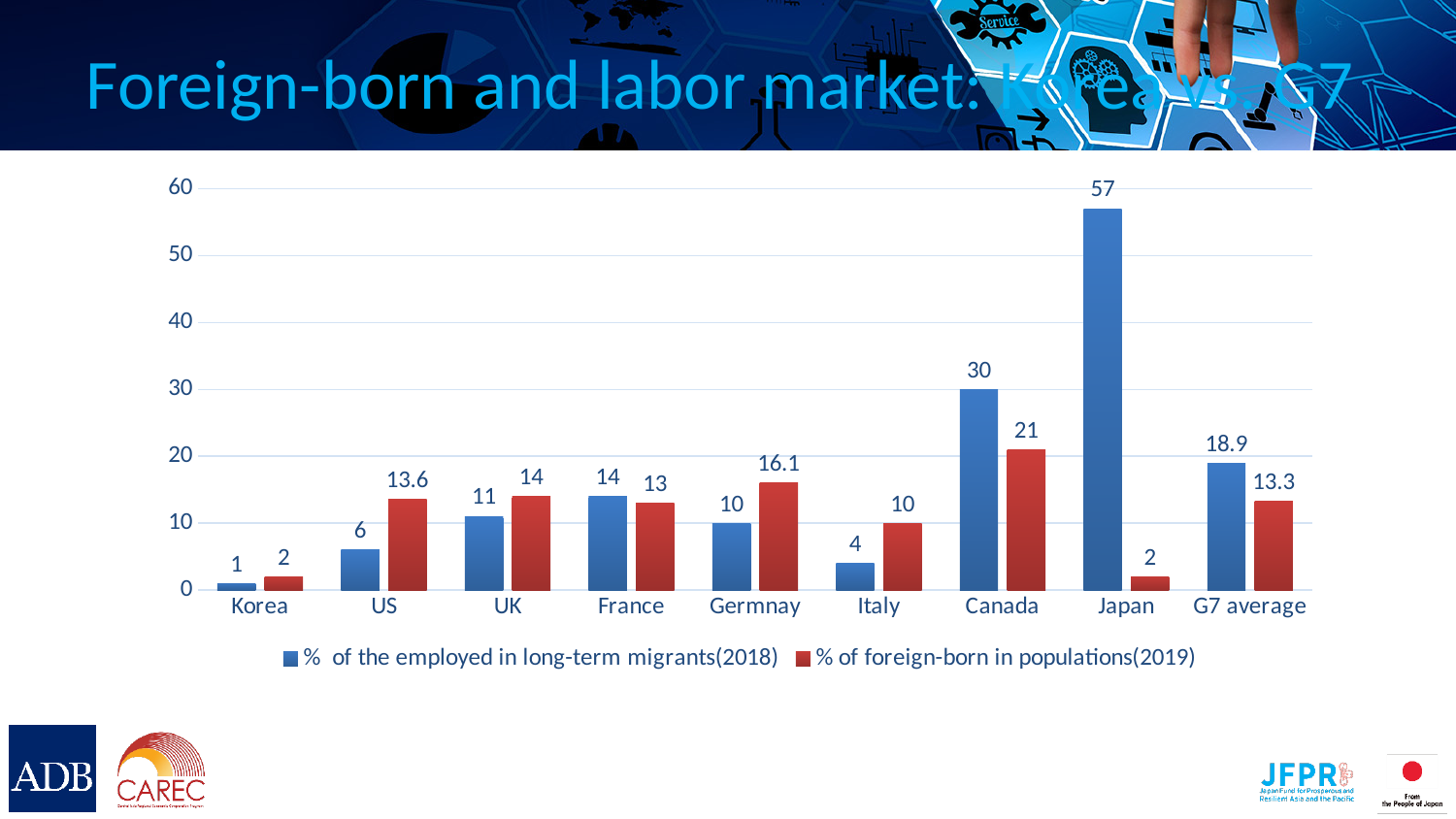
Which is larger for the US: the '% of the employed in long-term migrants(2018)' value or the '% of foreign-born in populations(2019)' value? % of foreign-born in populations(2019) Which category has the highest value in the '% of the employed in long-term migrants(2018)' series? Japan What is the value for Japan in the '% of the employed in long-term migrants(2018)' series? 57 What is the value for G7 average in the '% of the employed in long-term migrants(2018)' series? 18.9 Which category has the lowest value in the '% of foreign-born in populations(2019)' series? Korea and Japan (both 2) What colour are the bars for the '% of foreign-born in populations(2019)' series? red What kind of chart is shown on the slide? bar chart What is the value for Germnay in the '% of foreign-born in populations(2019)' series? 16.1 Is the value for Canada in the '% of the employed in long-term migrants(2018)' series greater or less than 20? greater How many categories are shown on the x axis? 9 What is the difference between Canada's and Japan's values in the '% of foreign-born in populations(2019)' series? 19 How many series does the legend list? 2